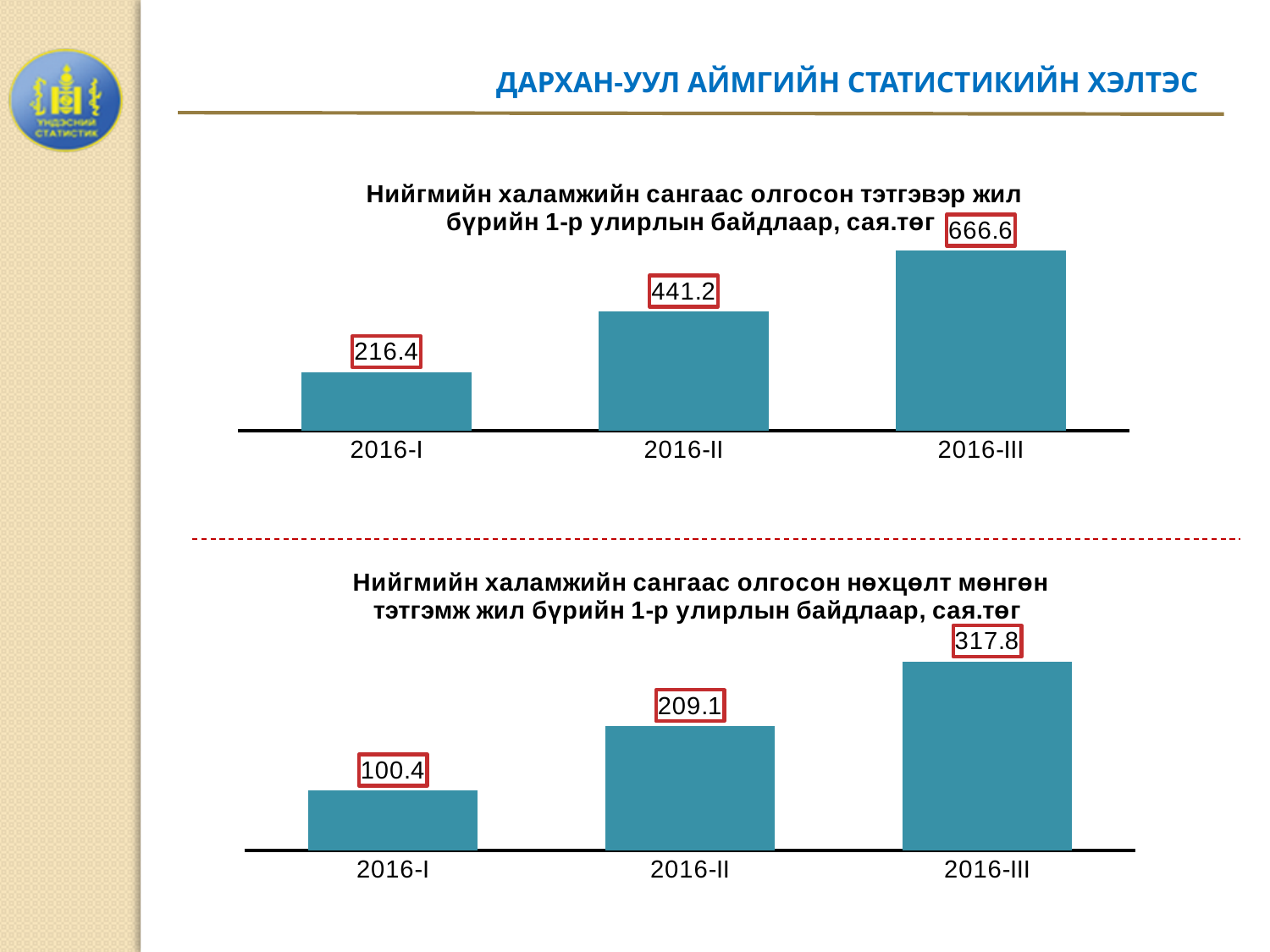
In the top chart, what is the value for 2016-III? 666.6 In the bottom chart, what is the value for 2016-III? 317.8 In the top chart, which period has the highest value? 2016-III How many bars are shown in the top chart? 3 In the top chart, do the values rise or fall from 2016-I to 2016-III? rise What type of chart is the bottom chart? bar chart In the bottom chart, what is the value for 2016-I? 100.4 In the top chart, what is the difference between the values for 2016-III and 2016-I? 450.2 In the bottom chart, what is the difference between the values for 2016-II and 2016-I? 108.7 In the bottom chart, which period has the lowest value? 2016-I In the bottom chart, which is larger, the value for 2016-II or 2016-III? 2016-III In the top chart, what is the value for 2016-II? 441.2